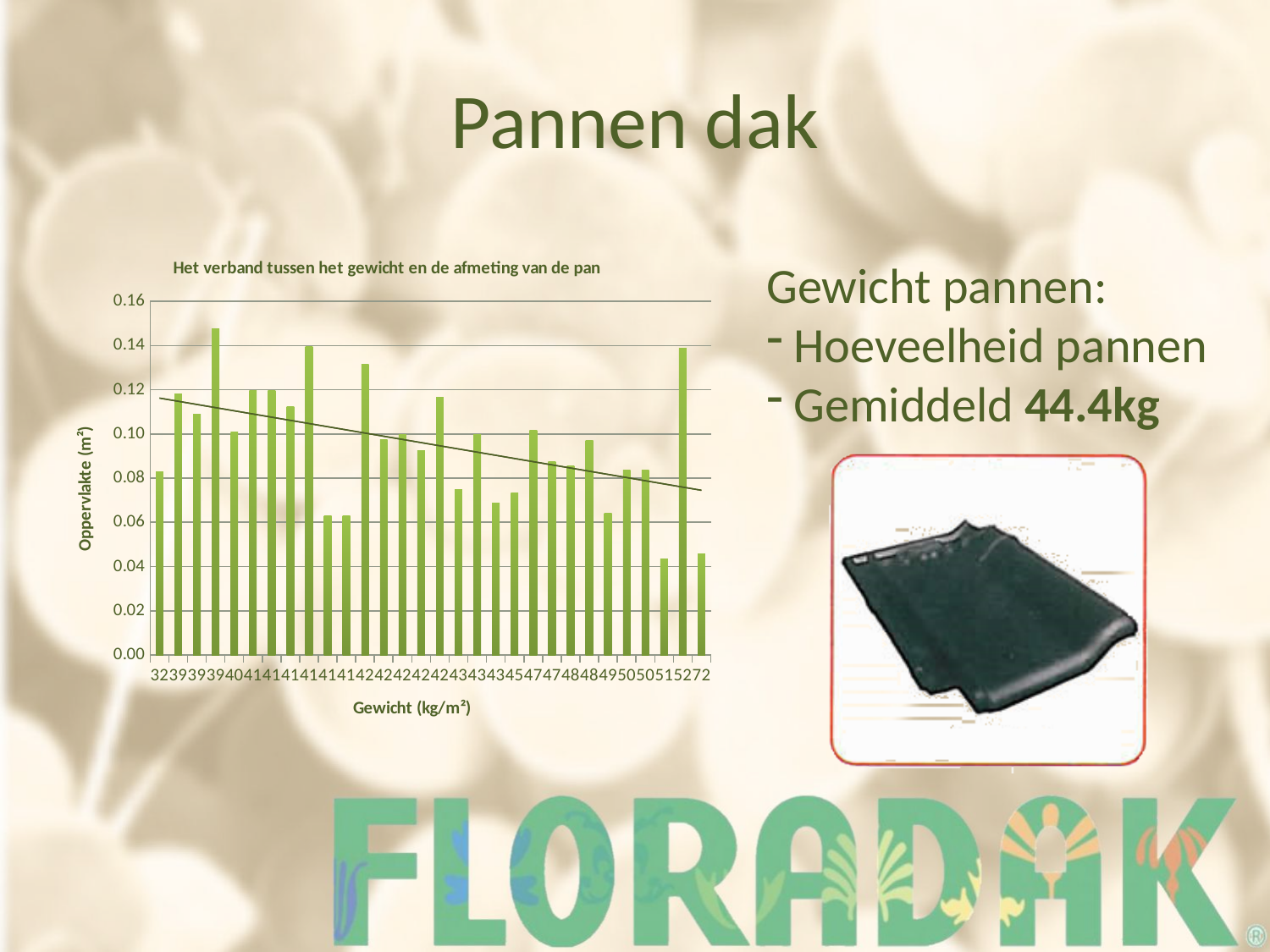
Is the value of the last bar (Gewicht 72) greater or less than 0.06? less Which is larger: the value of the first bar (Gewicht 32) or the value of the last bar (Gewicht 72)? Gewicht 32 Is the value of the second-to-last bar (Gewicht 52) greater or less than 0.12? greater What is the label of the vertical axis of the chart? Oppervlakte (m²) What is the title of the chart? Het verband tussen het gewicht en de afmeting van de pan What kind of chart is shown on the slide? bar chart Is the value of the first bar (Gewicht 32) greater or less than 0.10? less What is the highest value shown on the vertical axis of the chart? 0.16 According to the trend line in the chart, does the surface area (Oppervlakte) rise or fall as the weight (Gewicht) increases along the x axis? fall